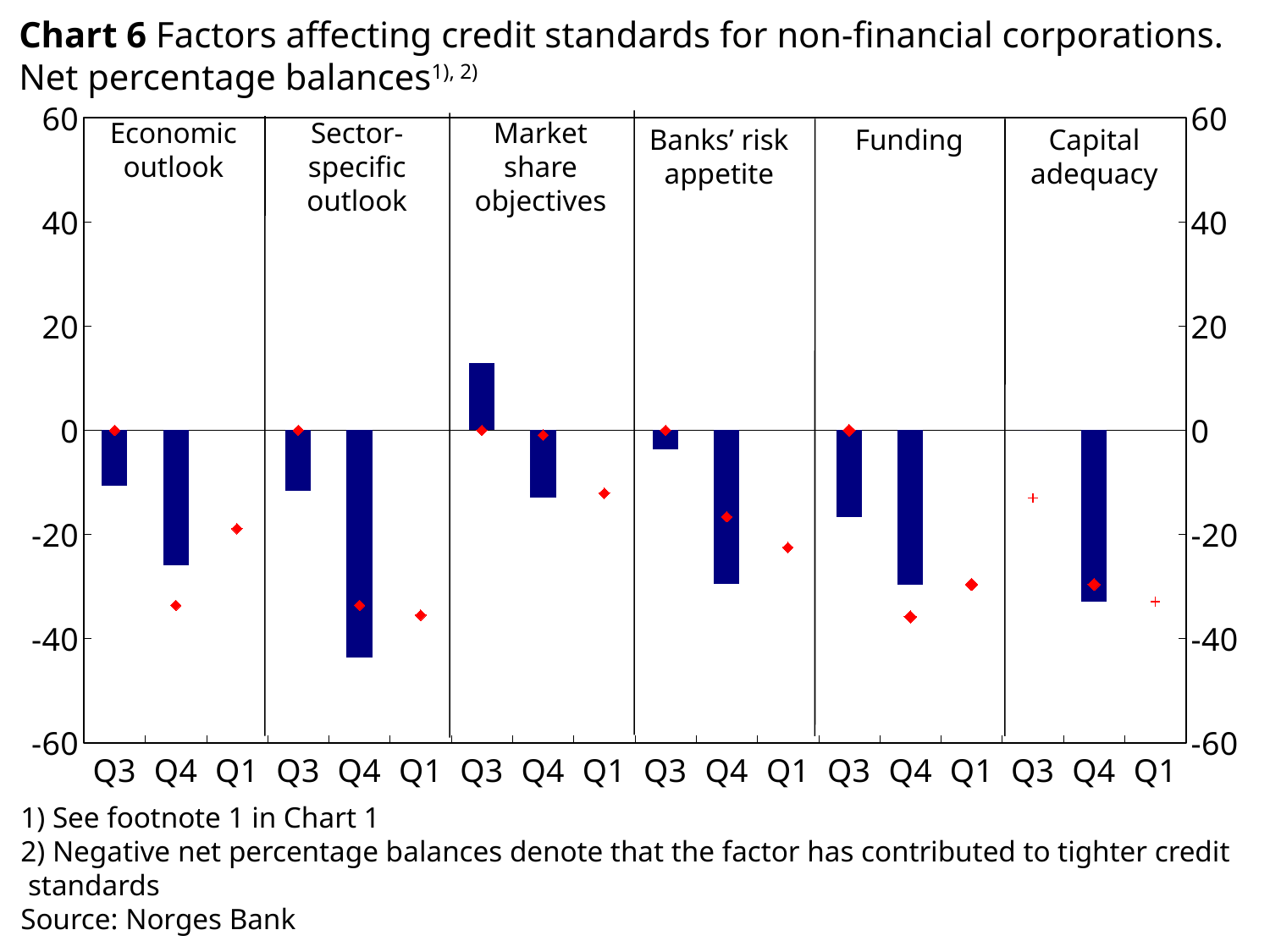
What kind of chart is Chart 6? bar chart Is the Q4 bar for Sector-specific outlook greater or less than -40? less Is the Q4 bar for Economic outlook greater or less than -20? less Is the Q4 bar for Banks' risk appetite greater or less than -20? less What is the source given for Chart 6? Norges Bank How many factor panels are shown in Chart 6? 6 In the Funding panel, does the bar rise or fall from Q3 to Q4? fall Which factor has the lowest Q4 bar in Chart 6? Sector-specific outlook In the Economic outlook panel, which bar is lower, Q3 or Q4? Q4 How many quarters are shown on the x axis within each panel of Chart 6? 3 Which factor is the only one with a positive Q3 bar in Chart 6? Market share objectives